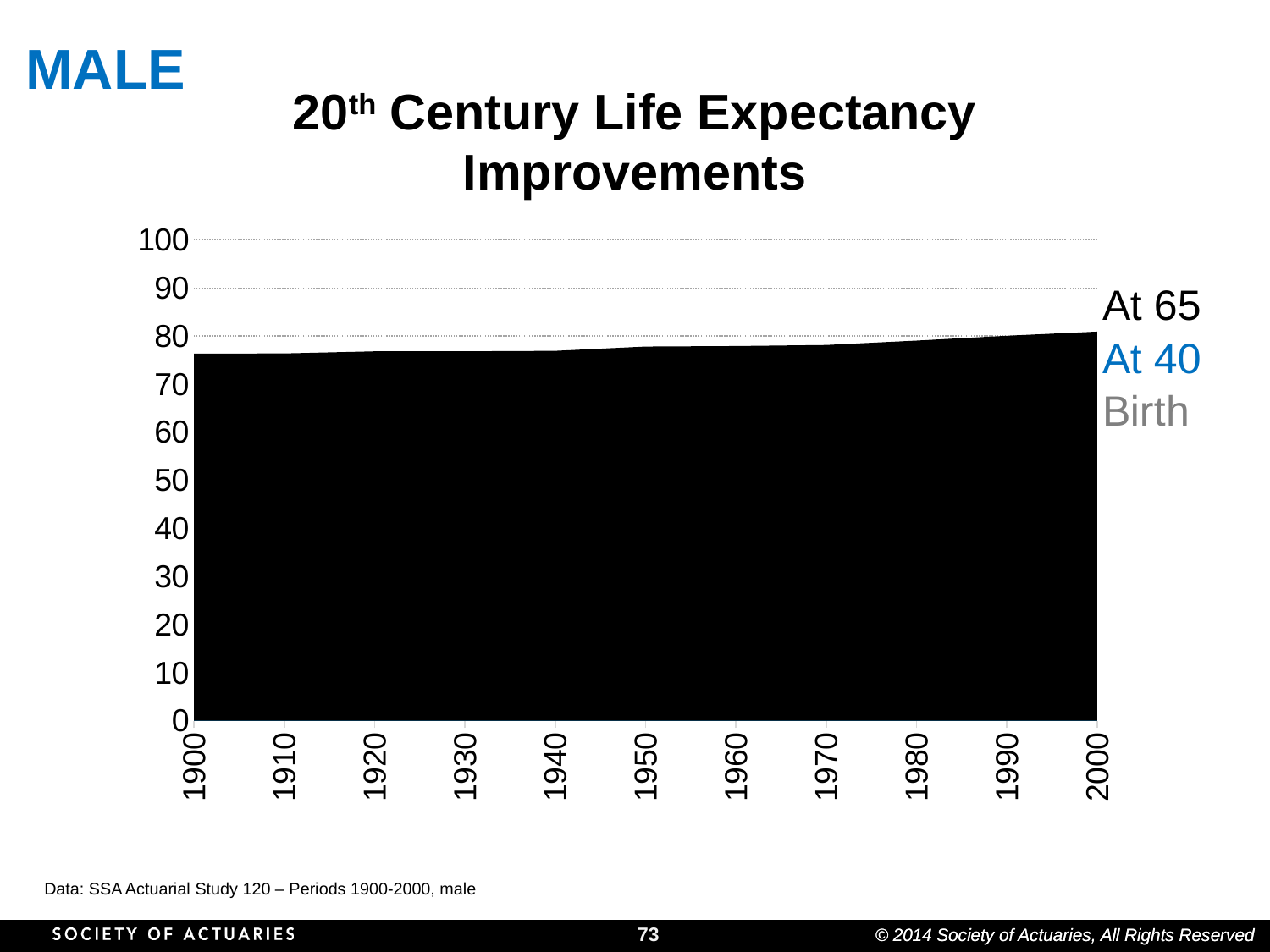
Is the value for 1900 greater or less than 70? greater Does the plotted value rise or fall from 1900 to 2000? Rise How many year labels are shown on the x axis? 11 Is the value for 1900 greater or less than 80? less Is the value for 1950 greater or less than 80? less In which year is the plotted value lowest? 1900 Which year has the larger value, 1900 or 2000? 2000 In which year is the plotted value highest? 2000 What kind of chart is shown on the slide? Area chart What is the title of the chart? 20th Century Life Expectancy Improvements What is the highest value shown on the y axis? 100